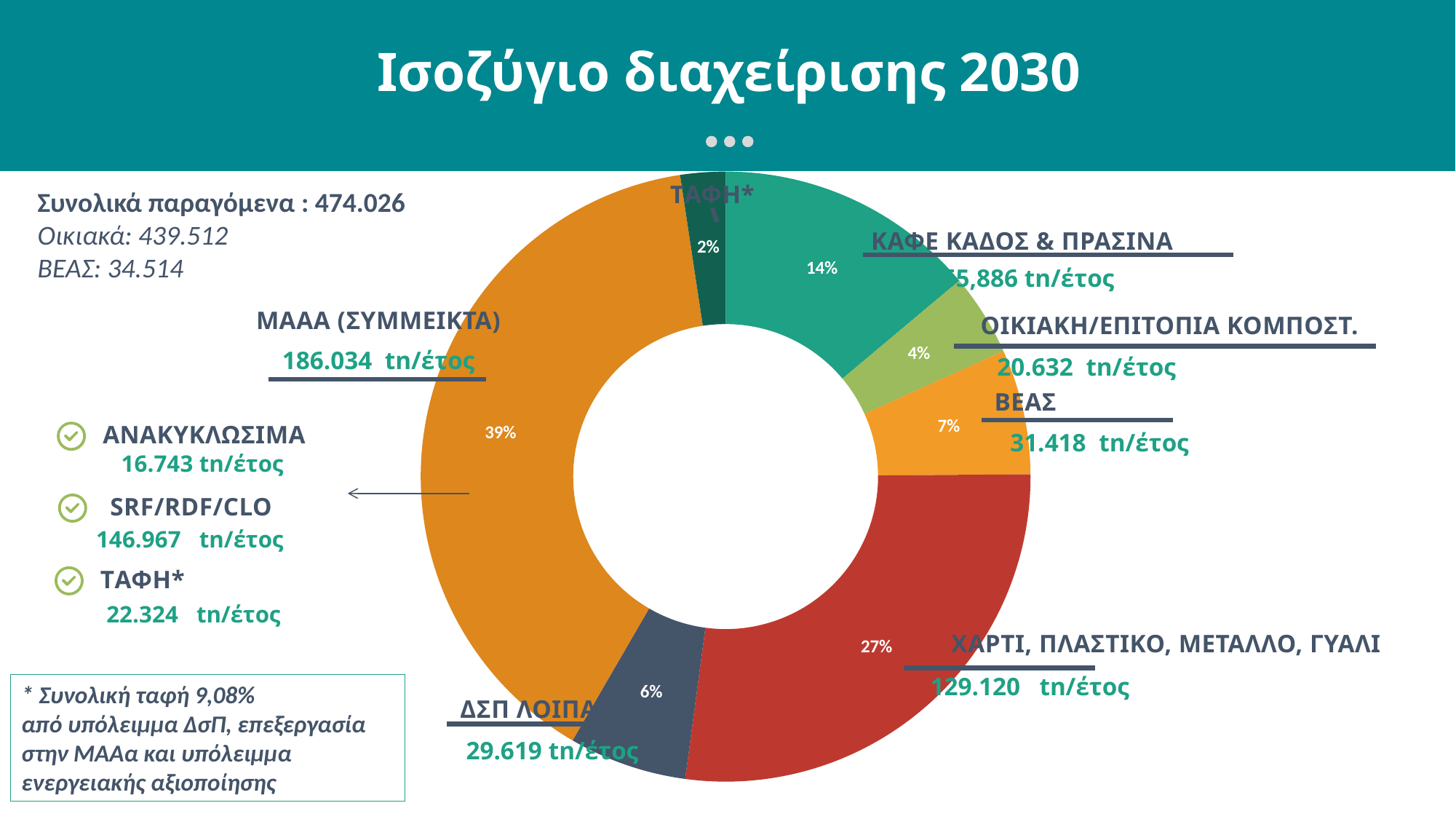
What percentage share does the ΧΑΡΤΙ, ΠΛΑΣΤΙΚΟ, ΜΕΤΑΛΛΟ, ΓΥΑΛΙ slice have? 27% What kind of chart is shown on the slide? Pie (donut) chart What is the difference in percentage points between the ΜΑΑΑ (ΣΥΜΜΕΙΚΤΑ) slice and the ΧΑΡΤΙ, ΠΛΑΣΤΙΚΟ, ΜΕΤΑΛΛΟ, ΓΥΑΛΙ slice? 12% How many slices does the chart have? 7 Which slice of the chart is the smallest? ΤΑΦΗ* Which slice of the chart is the largest? ΜΑΑΑ (ΣΥΜΜΕΙΚΤΑ) What is the annual quantity shown for ΒΕΑΣ? 31.418 tn/έτος What percentage share does the ΜΑΑΑ (ΣΥΜΜΕΙΚΤΑ) slice have? 39% What is the annual quantity shown for ΟΙΚΙΑΚΗ/ΕΠΙΤΟΠΙΑ ΚΟΜΠΟΣΤ.? 20.632 tn/έτος What percentage share does the ΚΑΦΕ ΚΑΔΟΣ & ΠΡΑΣΙΝΑ slice have? 14% What is the title of the slide's chart? Ισοζύγιο διαχείρισης 2030 What is the annual quantity shown for ΜΑΑΑ (ΣΥΜΜΕΙΚΤΑ)? 186.034 tn/έτος